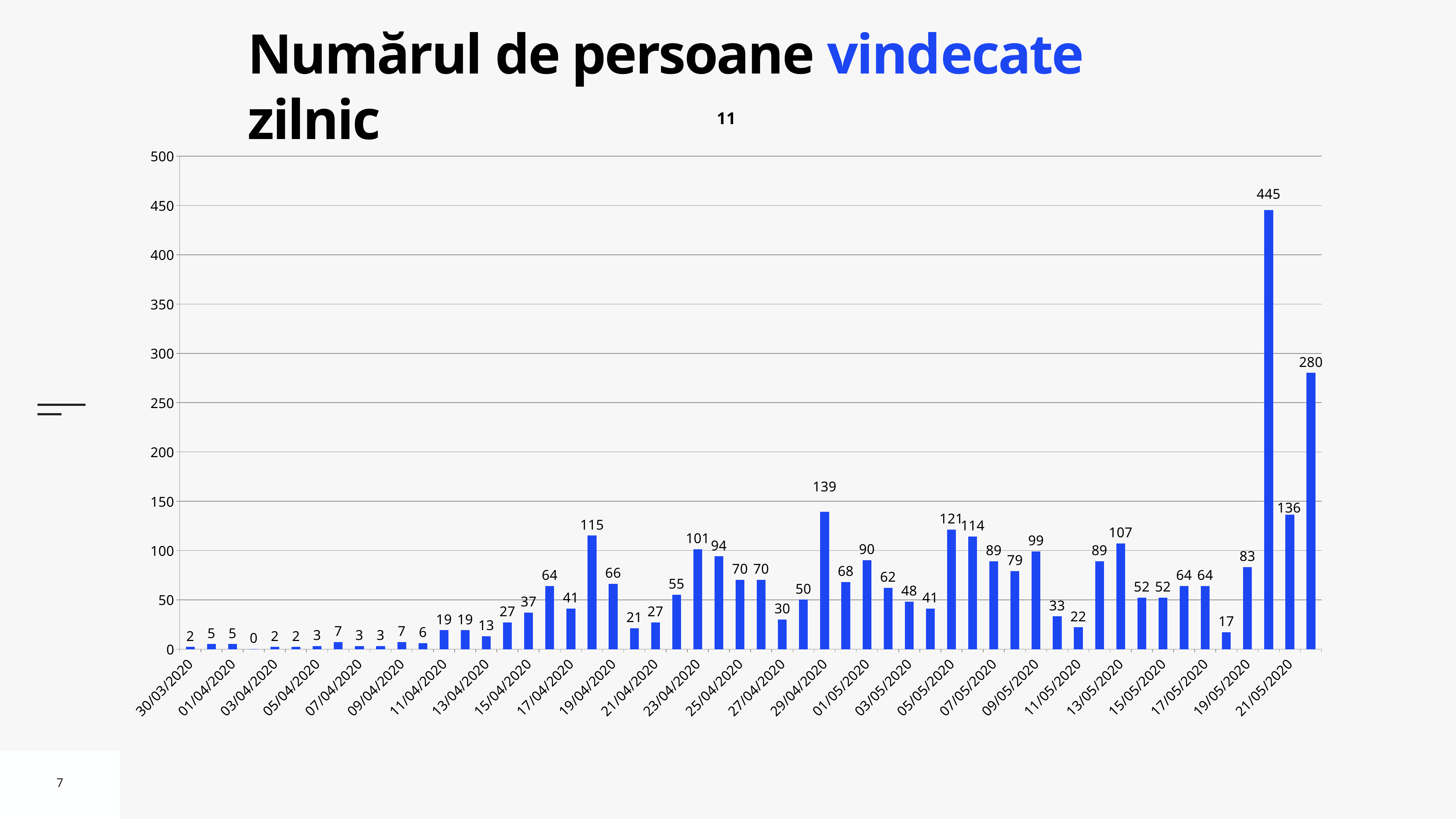
What is the highest value shown on the chart? 445 Is the value for 19/05/2020 greater or less than 50? greater What is the value for 13/05/2020? 107 What is the value for 05/05/2020? 121 What is the value for 29/04/2020? 139 How many bars are plotted on the chart? 54 What kind of chart is shown on the slide? bar chart What is the lowest value shown on the chart? 0 Which is larger, the value for 23/04/2020 or the value for 09/05/2020? 23/04/2020 What is the difference between the values for 29/04/2020 and 01/05/2020? 49 What is the title of the slide? Numărul de persoane vindecate zilnic What is the value for 11/05/2020? 22